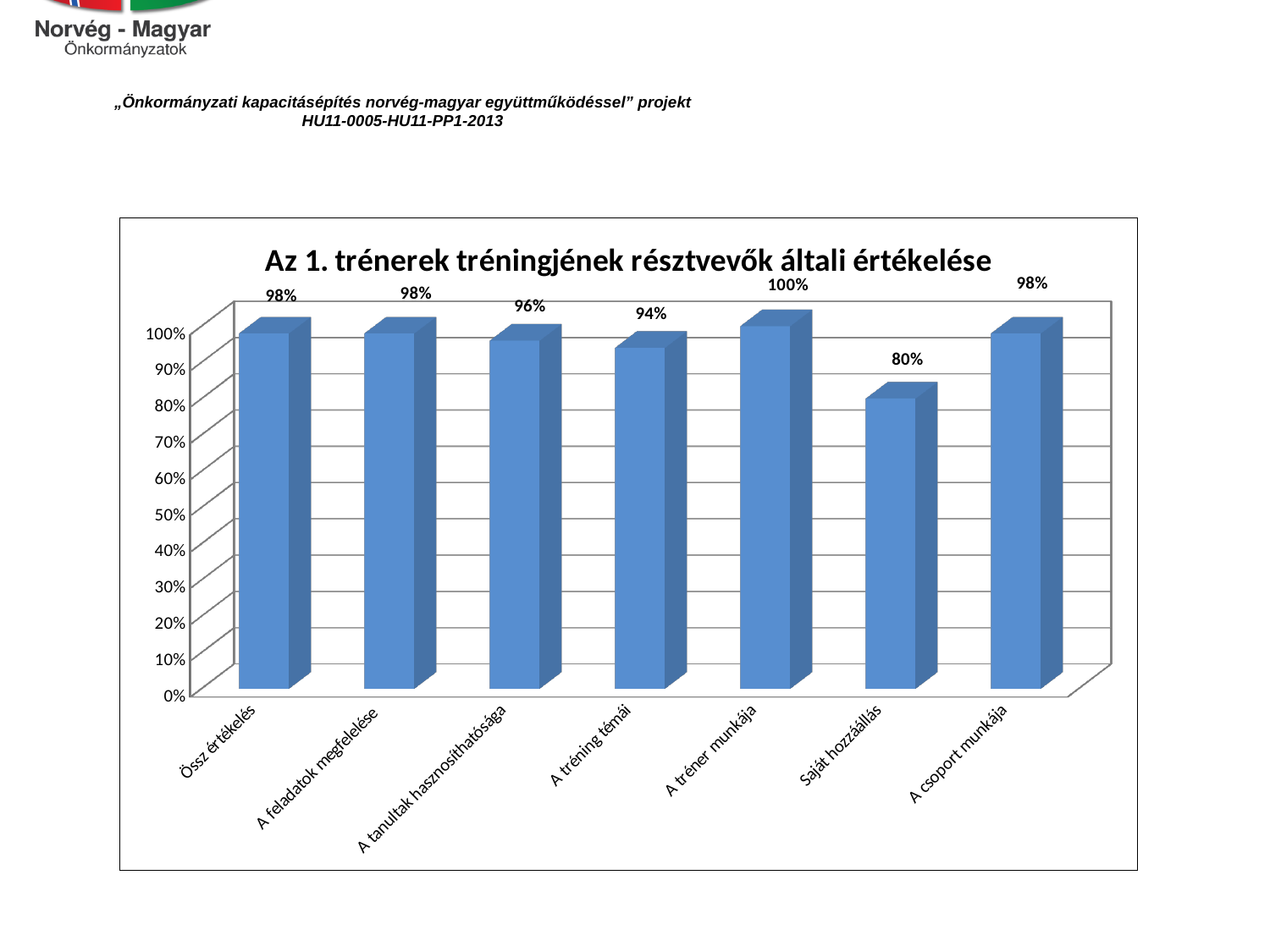
What is the title of the chart? Az 1. trénerek tréningjének résztvevők általi értékelése What is the value for "A tréner munkája"? 100% What kind of chart is shown on the slide? bar chart Is the value for "Saját hozzáállás" greater or less than 90%? less What is the difference between the values for "A tréner munkája" and "Saját hozzáállás"? 20% How many categories are shown on the x axis? 7 What is the value for "A tréning témái"? 94% Which category has the highest value? A tréner munkája What is the value for "Saját hozzáállás"? 80% What is the value for "A tanultak hasznosíthatósága"? 96% Which is larger, the value for "A tréning témái" or the value for "A csoport munkája"? A csoport munkája Which category has the lowest value? Saját hozzáállás